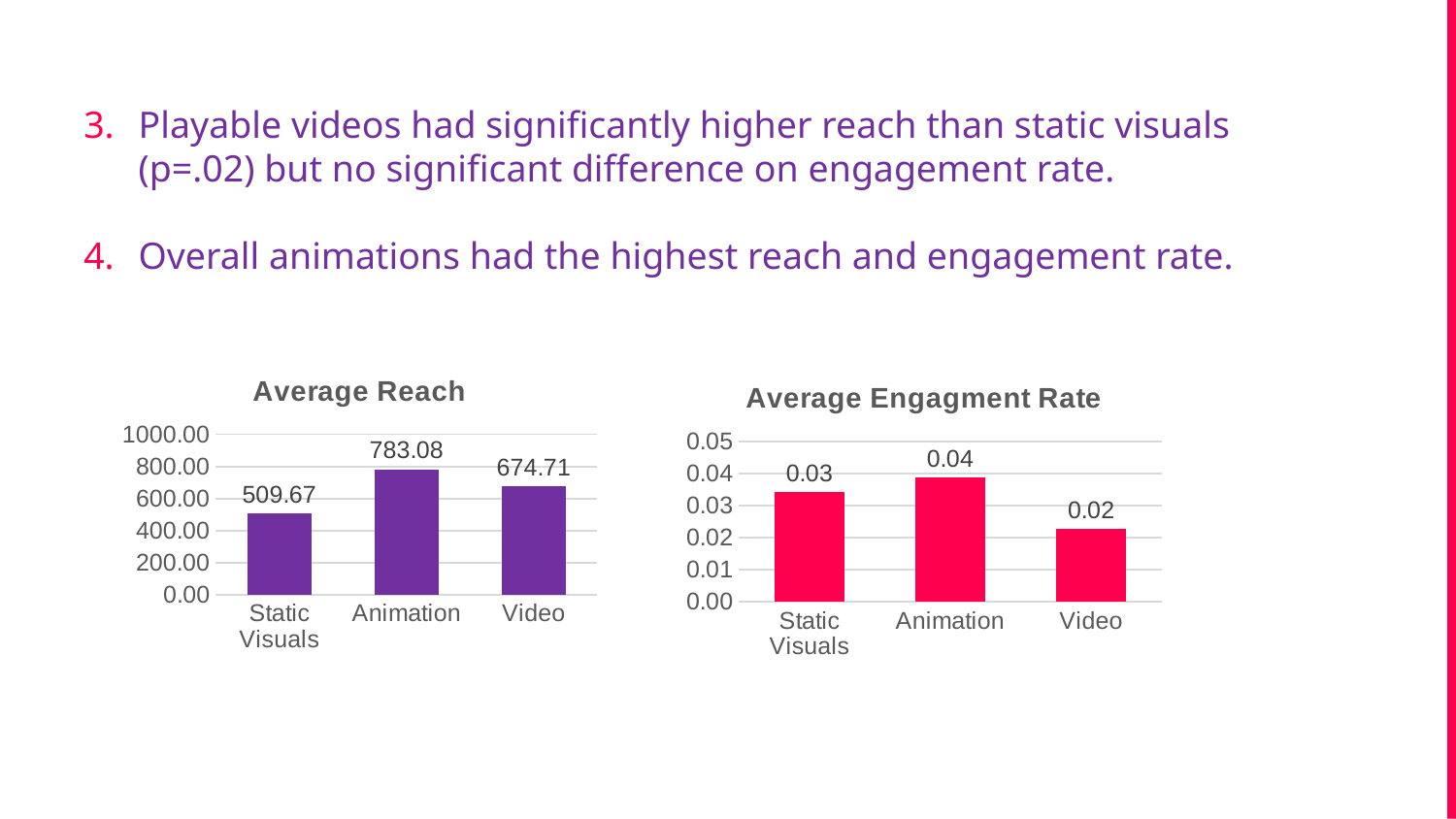
In the Average Reach chart, what is the difference between the values for Animation and Video? 108.37 In the Average Reach chart, what is the difference between the values for Animation and Static Visuals? 273.41 In the Average Reach chart, which is larger, the value for Video or the value for Static Visuals? Video What kind of chart is the Average Reach chart? bar chart In the Average Engagment Rate chart, what is the value for Video? 0.02 In the Average Engagment Rate chart, which category has the lowest value? Video In the Average Reach chart, what is the value for Animation? 783.08 In the Average Reach chart, is the value for Static Visuals greater or less than 600.00? less In the Average Reach chart, what is the value for Static Visuals? 509.67 In the Average Reach chart, which category has the highest value? Animation In the Average Engagment Rate chart, what is the value for Animation? 0.04 How many categories are shown in the Average Engagment Rate chart? 3